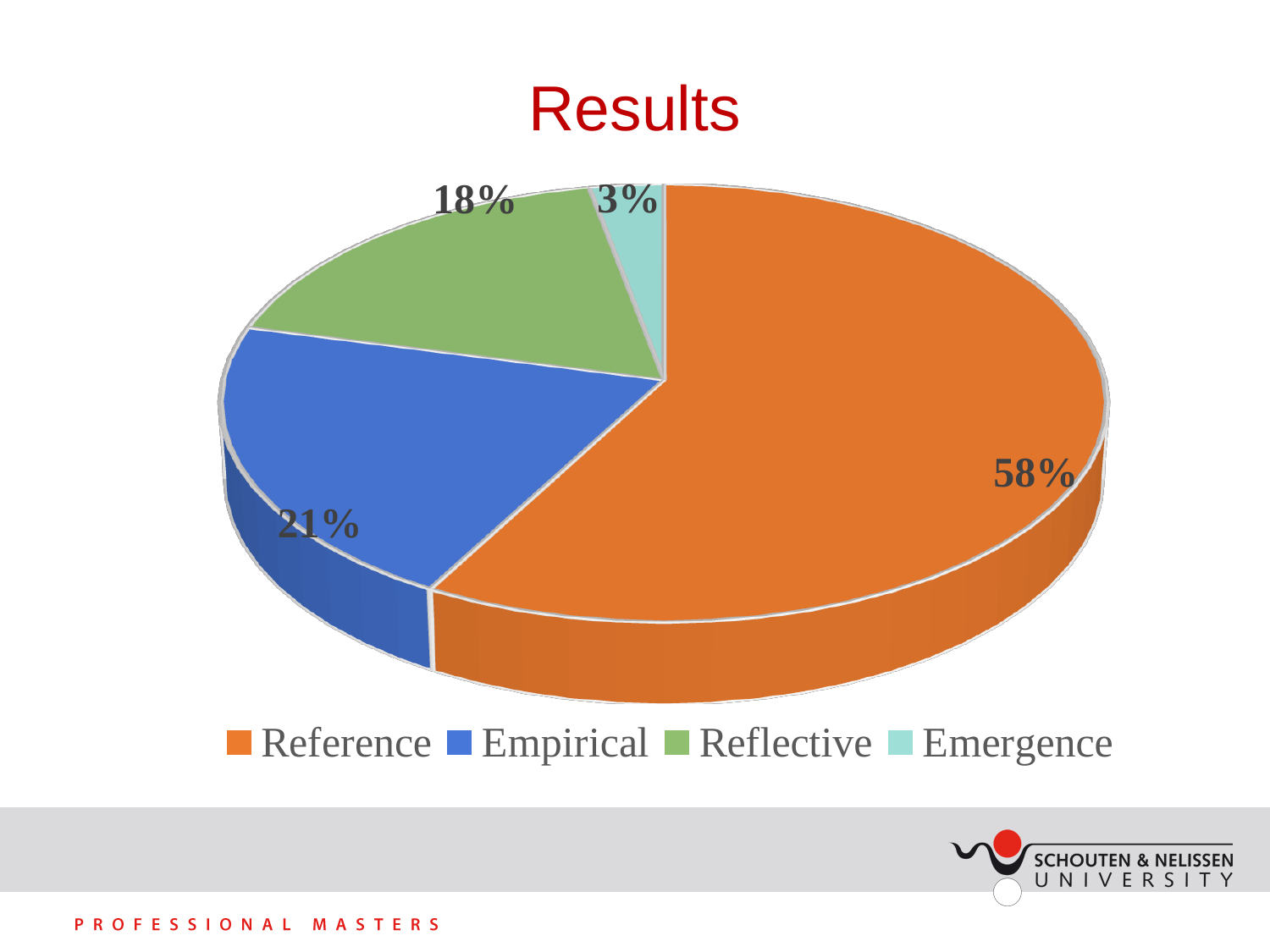
What is the difference in percentage points between Reference and Empirical? 37 What share of the pie does Empirical have? 21% What kind of chart is shown on the slide? pie chart What is the title of the slide containing the chart? Results Which is larger, the Empirical slice or the Reflective slice? Empirical What share of the pie does Emergence have? 3% Which category has the smallest slice of the pie? Emergence Which category has the largest slice of the pie? Reference What share of the pie does Reflective have? 18% What is the difference in percentage points between Reflective and Emergence? 15 How many categories does the pie chart show? 4